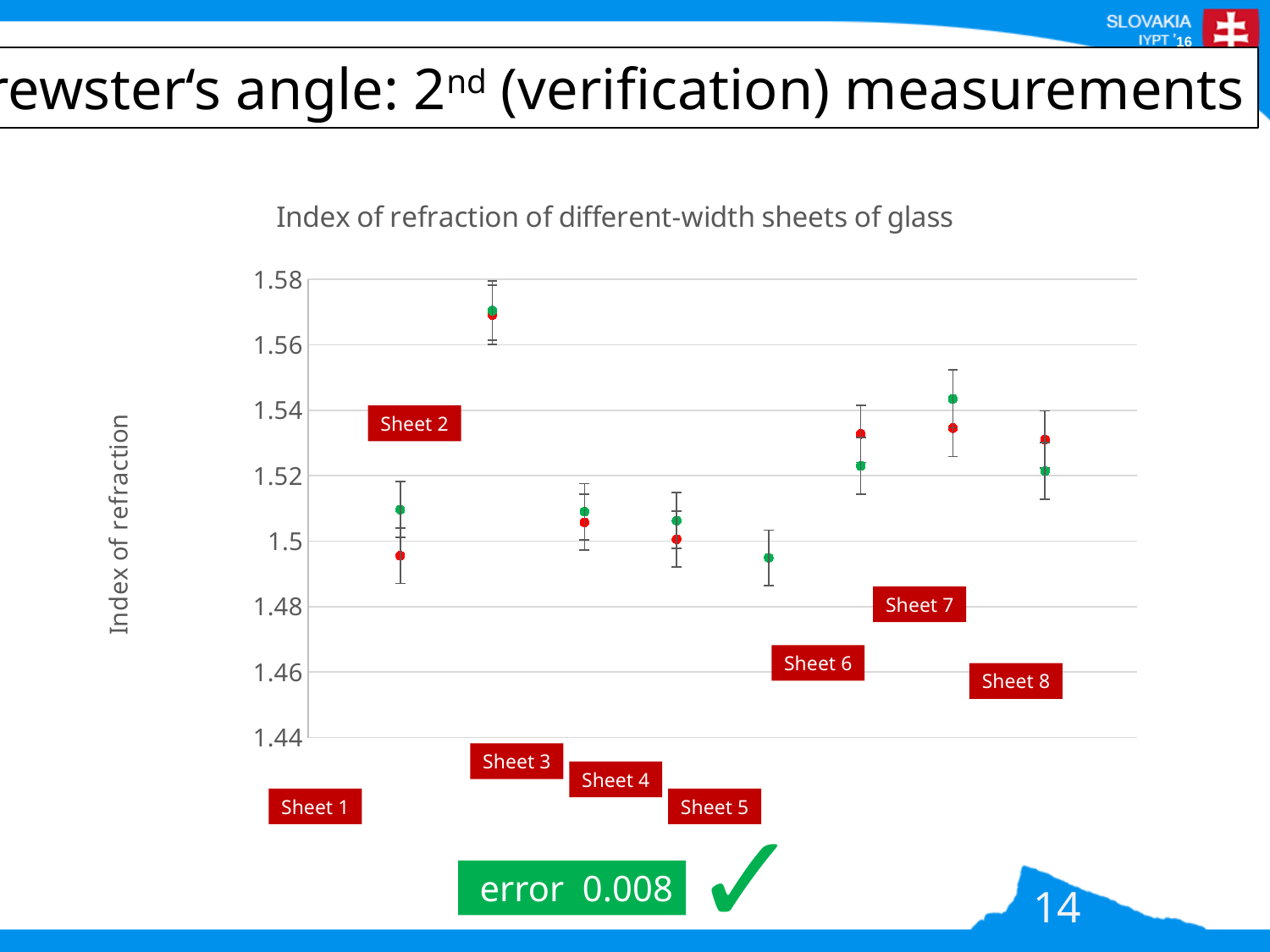
Is the green point for Sheet 7 greater or less than 1.52? greater Which has a higher index of refraction, Sheet 7 or Sheet 5? Sheet 7 How many sheets of glass are plotted on the chart? 8 Is the index of refraction for Sheet 3 greater or less than 1.52? less Which sheet has the highest index of refraction on the chart? Sheet 2 What is the title of the chart? Index of refraction of different-width sheets of glass Which has a higher index of refraction, Sheet 2 or Sheet 3? Sheet 2 Is the red point for Sheet 6 greater or less than 1.52? greater What kind of chart is shown on the slide? scatter chart What error value is shown in the green box below the chart? 0.008